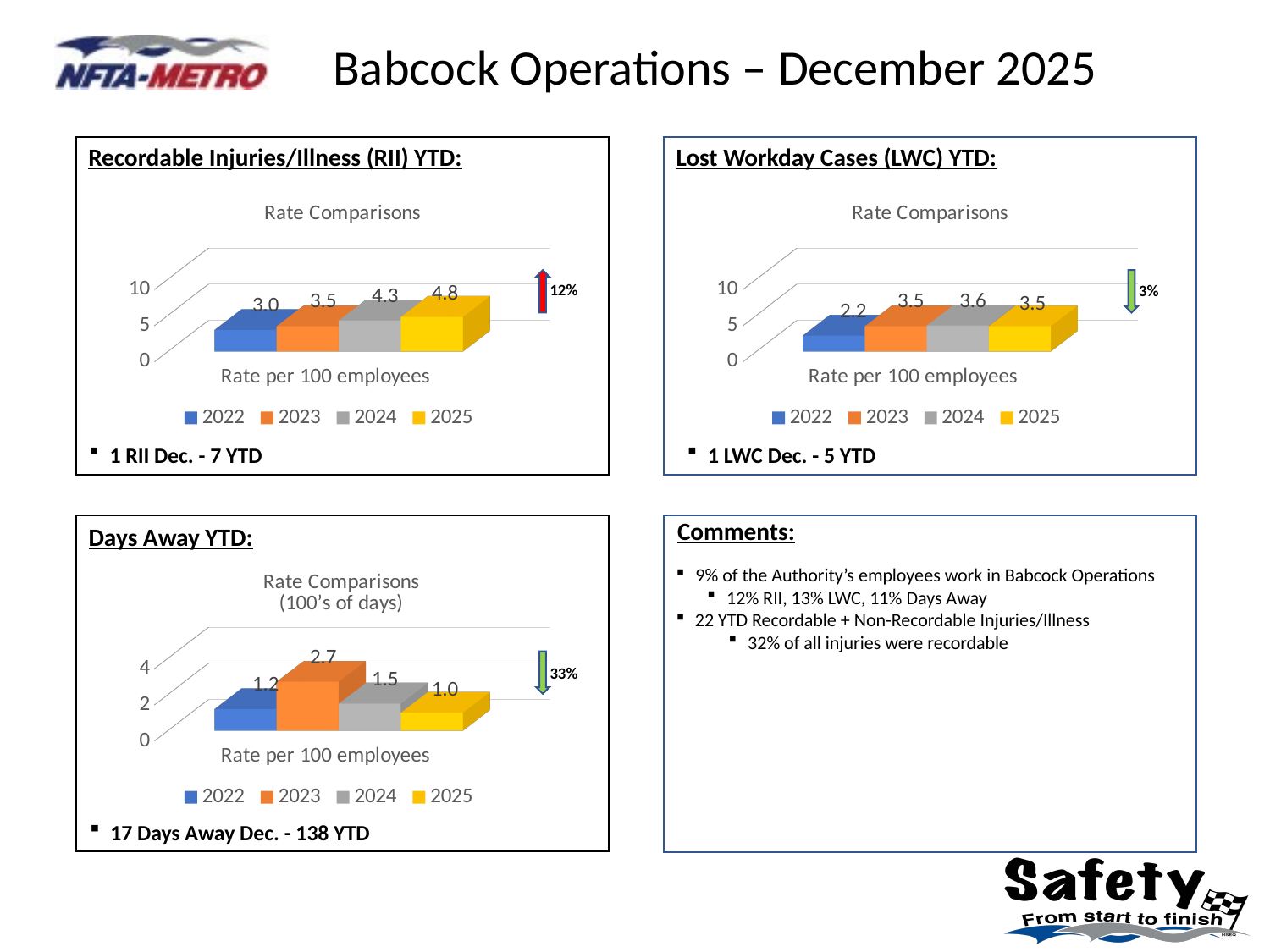
What is the title of the chart in the Recordable Injuries/Illness (RII) YTD box? Rate Comparisons In the Lost Workday Cases (LWC) YTD chart, what is the rate per 100 employees for 2022? 2.2 In the Recordable Injuries/Illness (RII) YTD chart, which year has the lowest rate? 2022 In the Lost Workday Cases (LWC) YTD chart, which year has the highest rate? 2024 In the Days Away YTD chart, which year has the lowest rate? 2025 In the Lost Workday Cases (LWC) YTD chart, how many series does the legend list? 4 In the Days Away YTD chart, what is the rate per 100 employees for 2023? 2.7 In the Days Away YTD chart, which is larger, the 2022 rate or the 2024 rate? 2024 What kind of chart is the Days Away YTD chart? bar chart In the Recordable Injuries/Illness (RII) YTD chart, what is the difference between the 2025 and 2022 rates? 1.8 In the Recordable Injuries/Illness (RII) YTD chart, do the rates rise or fall from 2022 to 2025? rise In the Recordable Injuries/Illness (RII) YTD chart, what is the rate per 100 employees for 2025? 4.8